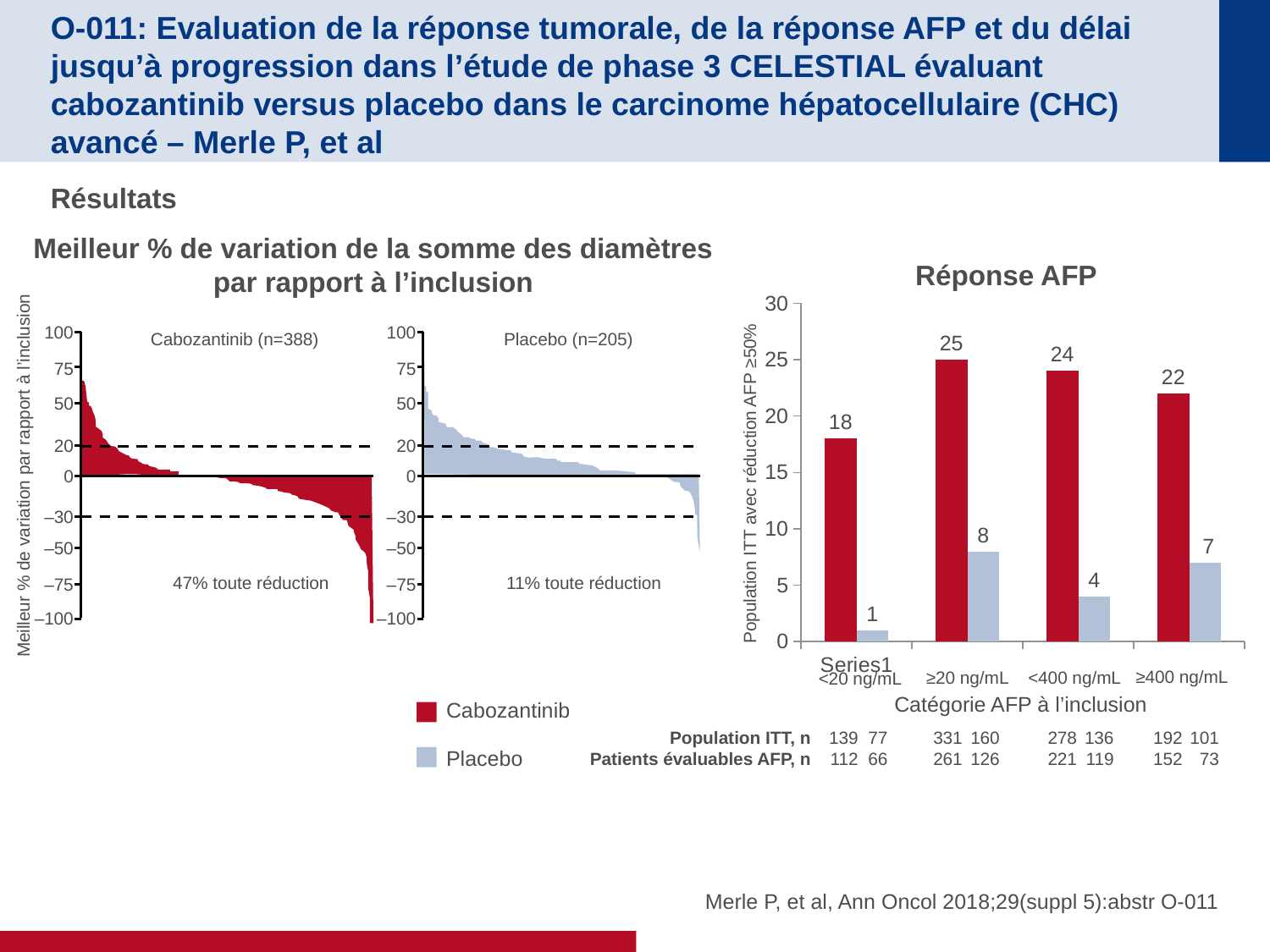
In the 'Réponse AFP' chart, which AFP category has the lowest Placebo value? <20 ng/mL In the 'Réponse AFP' chart, what is the value for Cabozantinib in the ≥20 ng/mL category? 25 How many AFP categories are shown on the x axis of the 'Réponse AFP' chart? 4 In the 'Réponse AFP' chart, is the Cabozantinib value for <20 ng/mL greater or less than 20? less In the left waterfall charts, what percentage of Cabozantinib patients had any reduction ('toute réduction')? 47% How many series does the legend list for the 'Réponse AFP' chart? 2 In the 'Réponse AFP' chart, which AFP category has the highest Cabozantinib value? ≥20 ng/mL In the 'Réponse AFP' chart, what is the difference between the Cabozantinib and Placebo values in the ≥400 ng/mL category? 15 In the 'Réponse AFP' chart, which is larger: the Placebo value for ≥20 ng/mL or the Placebo value for ≥400 ng/mL? ≥20 ng/mL What kind of chart is the 'Réponse AFP' chart? bar chart In the 'Réponse AFP' chart, what is the value for Placebo in the <400 ng/mL category? 4 In the 'Réponse AFP' chart, what is the value for Placebo in the <20 ng/mL category? 1